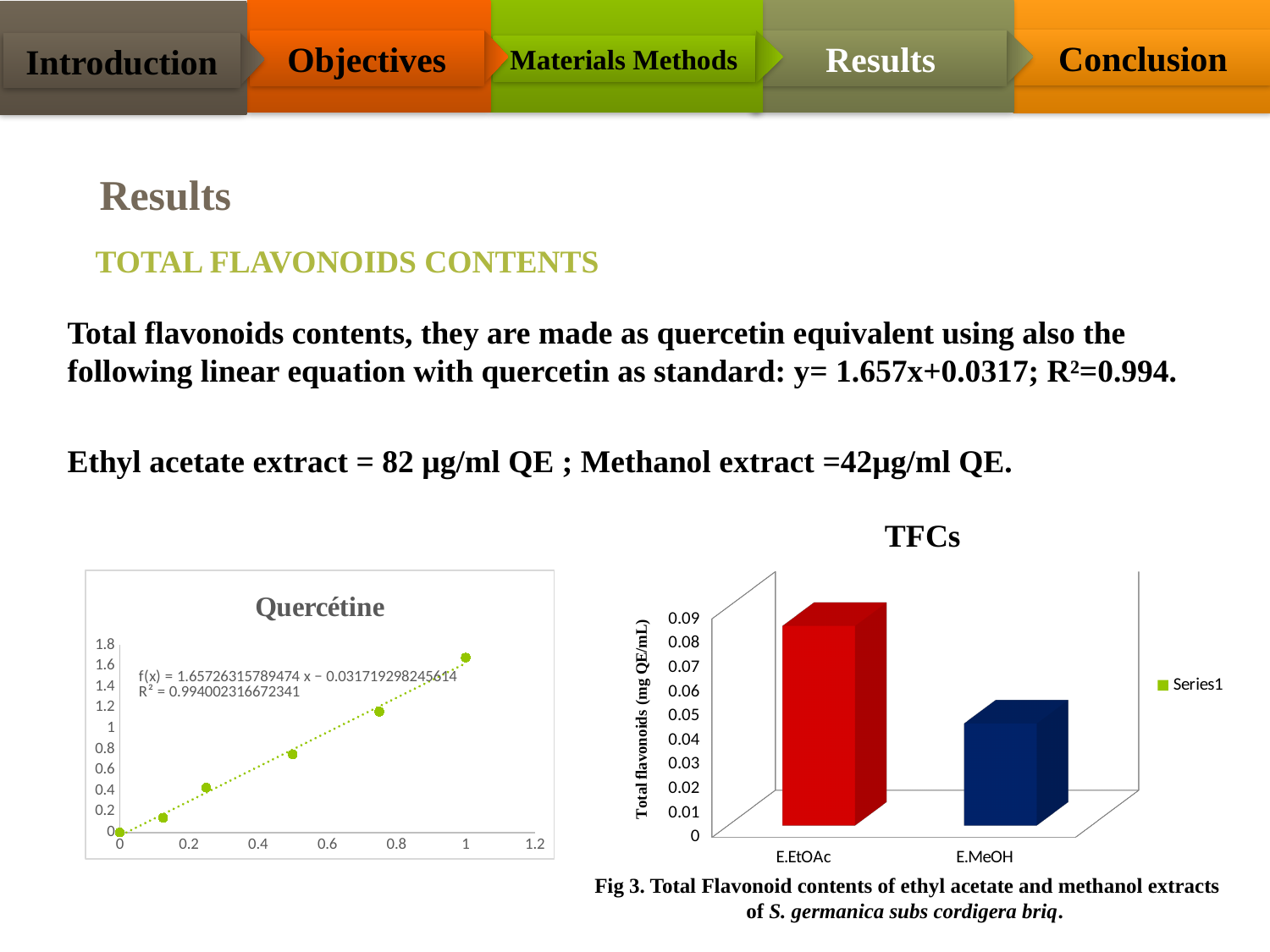
What kind of chart is the TFCs chart? bar chart On the TFCs chart, is the value for E.MeOH greater or less than 0.06? less On the TFCs chart, how many series does the legend list? 1 On the Quercétine chart, how many data points are plotted? 6 On the TFCs chart, how many extracts (categories) are plotted? 2 What R² value is printed on the Quercétine chart? 0.994002316672341 What is the y-axis title of the TFCs chart? Total flavonoids (mg QE/mL) On the TFCs chart, is the value for E.MeOH greater or less than 0.03? greater On the TFCs chart, is the value for E.EtOAc greater or less than 0.07? greater On the Quercétine chart, do the values rise or fall as x increases? rise On the TFCs chart, which extract has the higher total flavonoid content? E.EtOAc On the TFCs chart, which extract has the lower total flavonoid content? E.MeOH